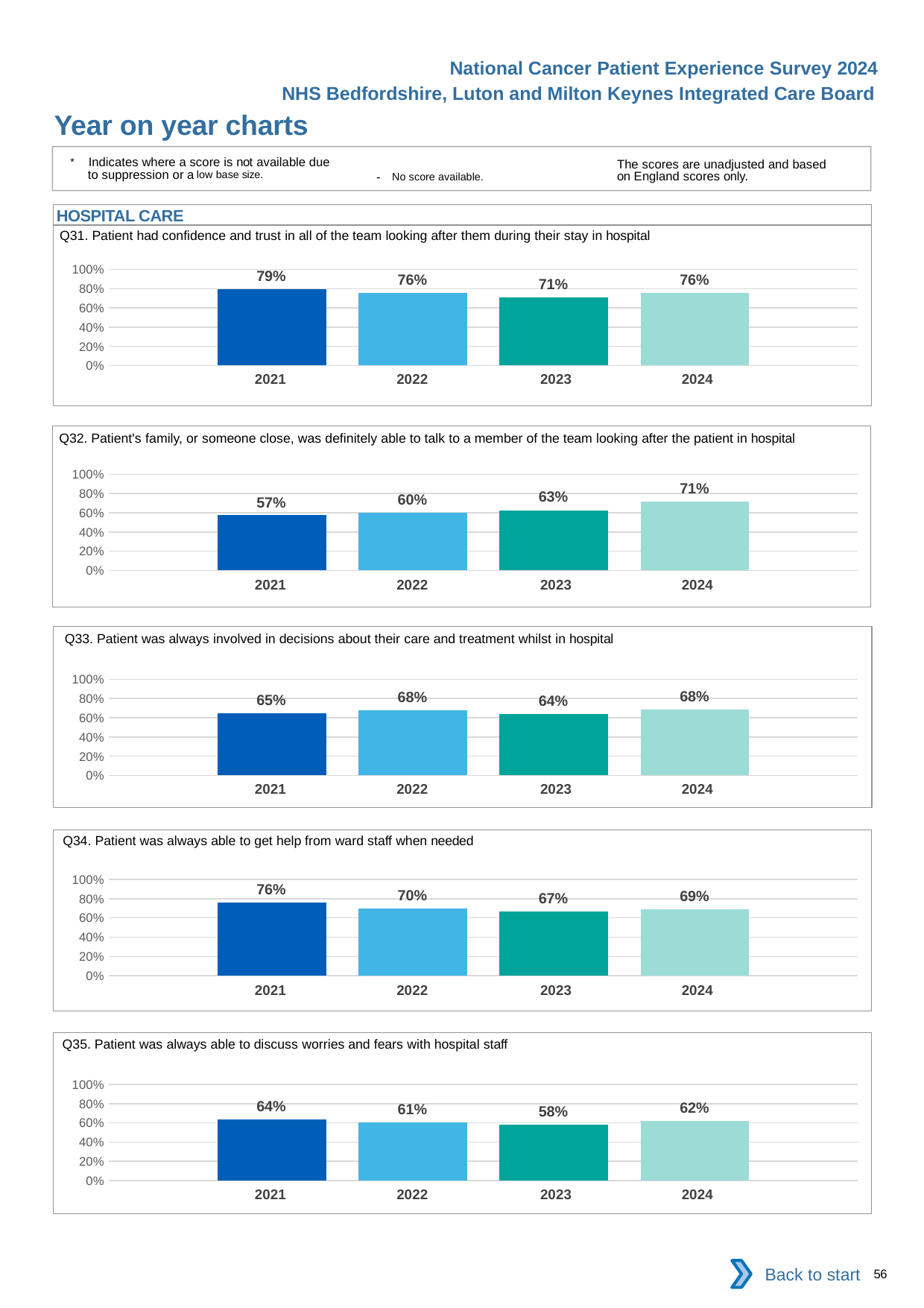
In the Q31 chart (patient had confidence and trust in all of the team), which year has the lowest value? 2023 In the Q33 chart (patient was always involved in decisions about their care), what is the value for 2023? 64% In the Q35 chart (patient was always able to discuss worries and fears), which is larger, the value for 2022 or 2024? 2024 In the Q34 chart (patient was always able to get help from ward staff), which year has the highest value? 2021 What type of chart is used for Q31? bar chart In the Q34 chart (patient was always able to get help from ward staff), what is the difference between the 2021 and 2023 values? 9% In the Q32 chart (patient's family was definitely able to talk to a member of the team), what is the value for 2024? 71% In the Q33 chart (patient was always involved in decisions about their care), how many years are plotted? 4 In the Q35 chart (patient was always able to discuss worries and fears), is the value for 2023 greater or less than 60%? less In the Q32 chart (patient's family was definitely able to talk to a member of the team), what is the difference between the 2024 and 2021 values? 14% In the Q31 chart (patient had confidence and trust in all of the team), what is the value for 2021? 79% In the Q32 chart (patient's family was definitely able to talk to a member of the team), do the values rise or fall from 2021 to 2024? rise